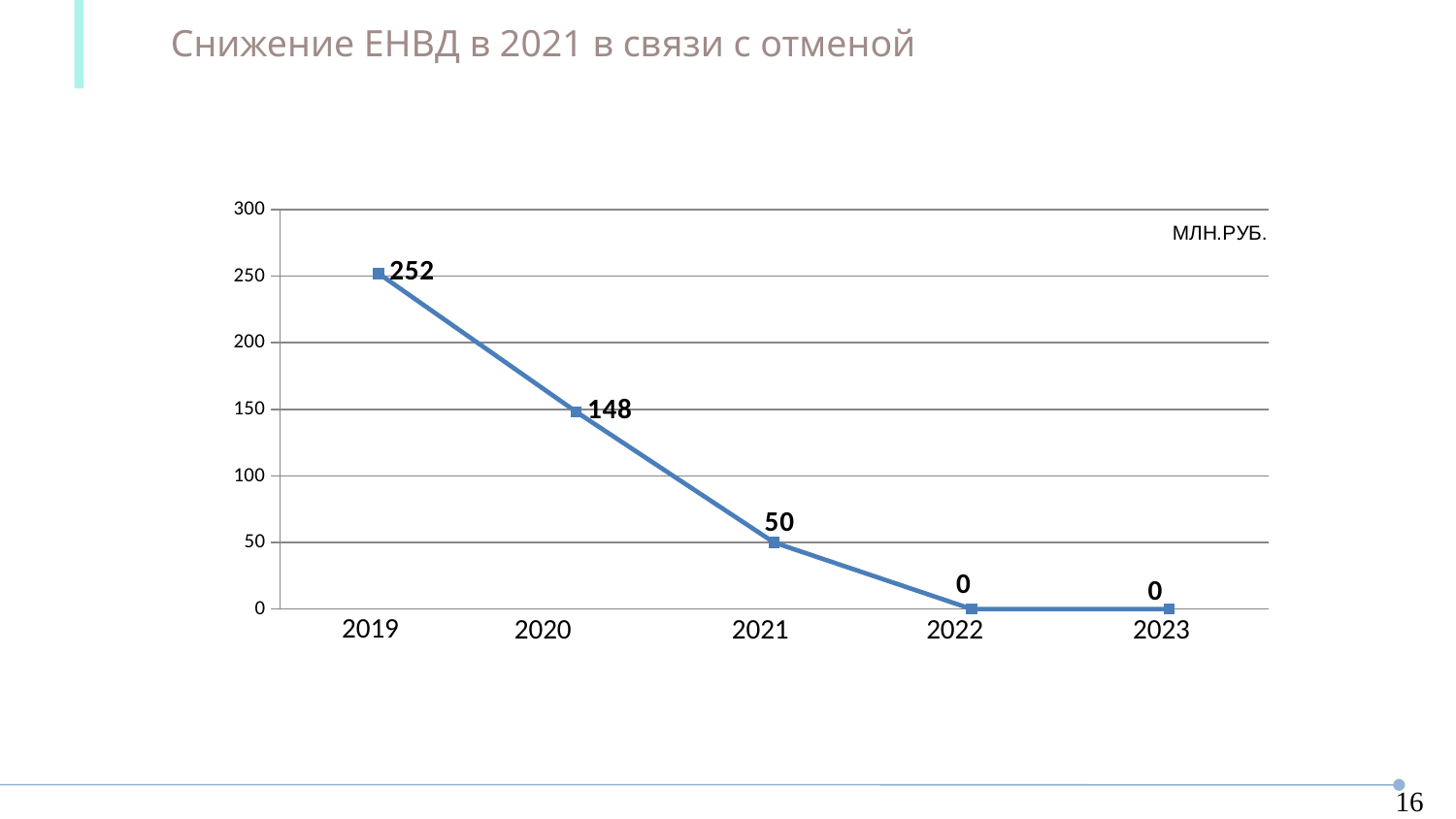
What is the value for 2020? 148 What kind of chart is shown on the slide? line chart Is the value for 2019 greater or less than 200? greater What is the value for 2021? 50 How many years are plotted on the x axis? 5 Which year has the highest value? 2019 What is the value for 2022? 0 Which is larger, the value for 2020 or the value for 2021? 2020 What is the value for 2019? 252 Do the values rise or fall from 2019 to 2022? fall What is the difference between the values for 2020 and 2021? 98 What is the difference between the values for 2019 and 2020? 104